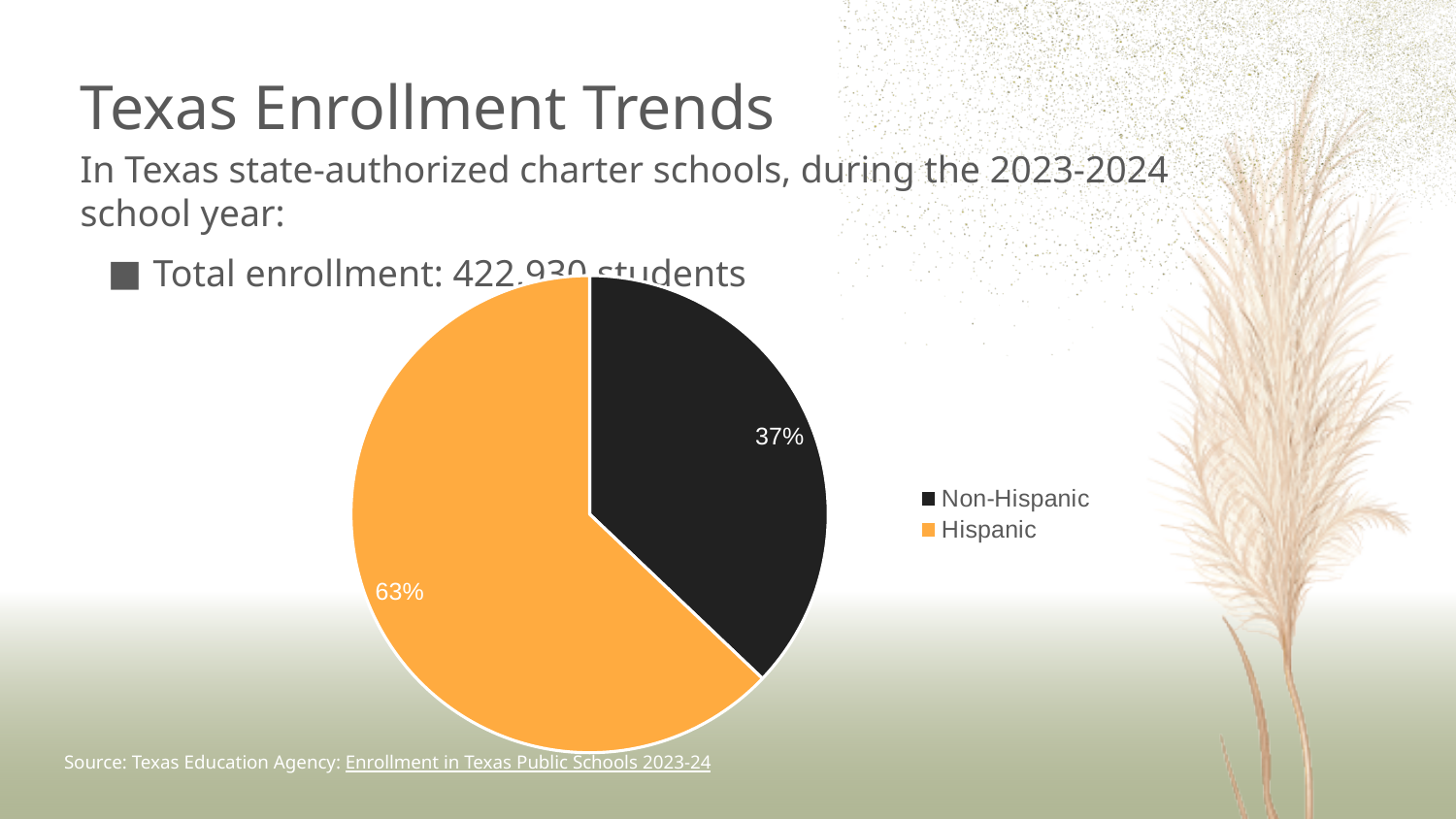
What percentage of the pie is Hispanic? 63% Which is larger, the Hispanic slice or the Non-Hispanic slice? Hispanic Which slice of the pie is the largest? Hispanic What colour is the Hispanic slice? Orange What is the difference in percentage points between the Hispanic and Non-Hispanic slices? 26 What share of the pie does the Non-Hispanic slice represent? 37% Which slice of the pie is the smallest? Non-Hispanic How many slices does the pie chart have? 2 How many entries does the legend list? 2 What colour is the Non-Hispanic slice? Black What kind of chart is shown on the slide? Pie chart What percentage of the pie is Non-Hispanic? 37%